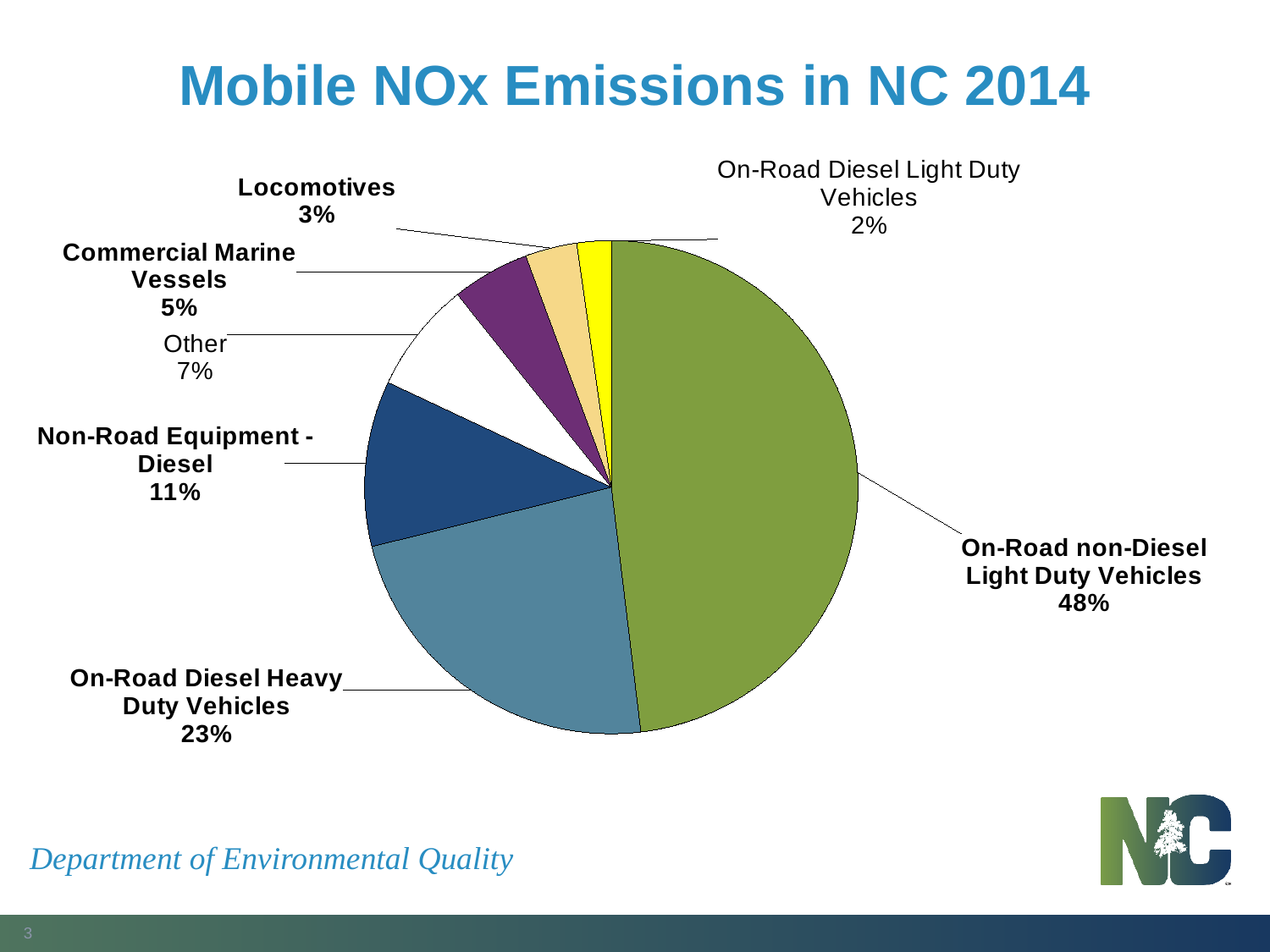
What percentage is shown for On-Road Diesel Heavy Duty Vehicles? 23% What is the difference in percentage points between On-Road non-Diesel Light Duty Vehicles and On-Road Diesel Heavy Duty Vehicles? 25 percentage points How many categories are shown in the pie chart? 7 Which category has the largest share of the pie? On-Road non-Diesel Light Duty Vehicles What share of mobile NOx emissions comes from On-Road non-Diesel Light Duty Vehicles? 48% Which is larger, the share for Other or the share for Commercial Marine Vessels? Other What percentage is shown for Locomotives? 3% What percentage is shown for Non-Road Equipment - Diesel? 11% What percentage is shown for Commercial Marine Vessels? 5% What is the title of the chart? Mobile NOx Emissions in NC 2014 Which category has the smallest share of the pie? On-Road Diesel Light Duty Vehicles What type of chart is shown on the slide? pie chart